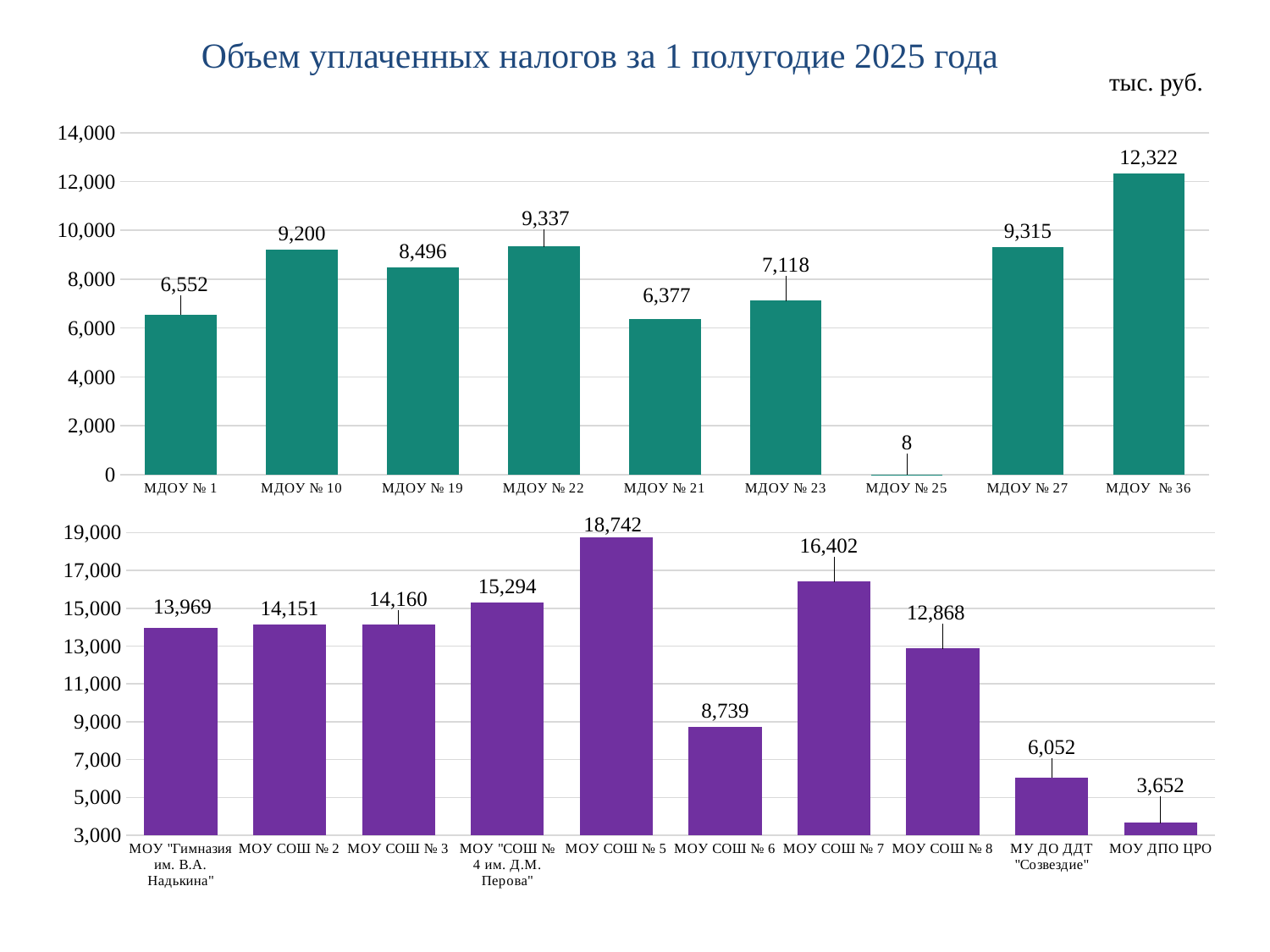
In the top chart, which category has the lowest value? МДОУ № 25 In the bottom chart, which category has the lowest value? МОУ ДПО ЦРО In the top chart, what is the difference between the values for МДОУ № 36 and МДОУ № 1? 5,770 In the bottom chart, which category has the highest value? МОУ СОШ № 5 What is the title of the slide's chart? Объем уплаченных налогов за 1 полугодие 2025 года In the bottom chart, which is larger: the value for МОУ СОШ № 6 or the value for МОУ СОШ № 8? МОУ СОШ № 8 In the top chart, which category has the highest value? МДОУ № 36 In the bottom chart, what is the value for МОУ СОШ № 7? 16,402 In the bottom chart, what is the difference between the values for МОУ СОШ № 5 and МОУ СОШ № 6? 10,003 In the top chart, what is the value for МДОУ № 22? 9,337 In the bottom chart, how many categories are shown? 10 In the top chart, how many categories are shown? 9